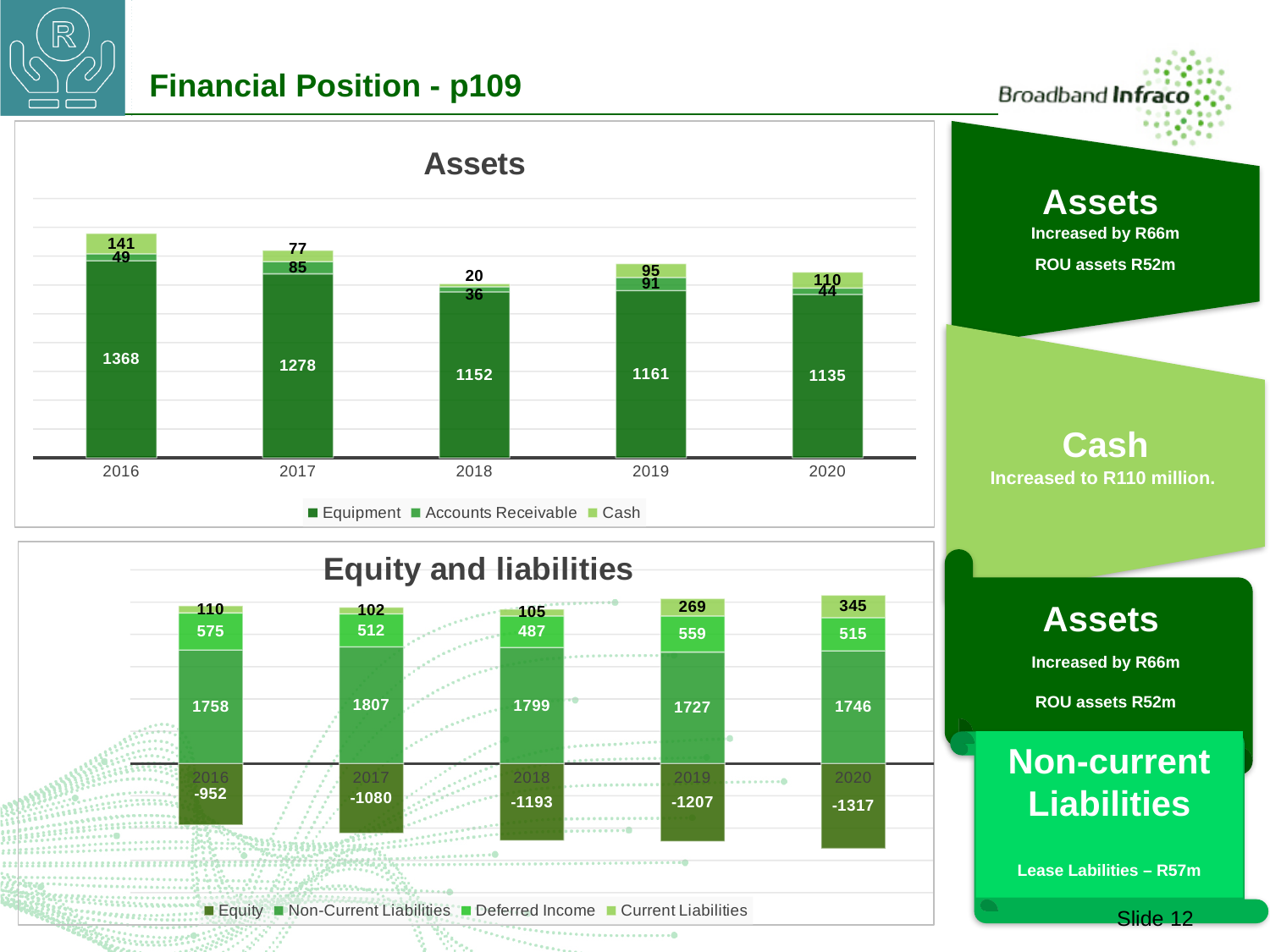
In the Assets chart, how many series does the legend list? 3 In the Equity and liabilities chart, how many categories are shown on the x axis? 5 In the Equity and liabilities chart, what is the Non-Current Liabilities value for 2017? 1807 In the Equity and liabilities chart, does the Equity value rise or fall from 2016 to 2020? Falls In the Assets chart, what is the difference between the Equipment values for 2016 and 2020? 233 In the Assets chart, what is the Equipment value for 2016? 1368 In the Assets chart, what is the Cash value for 2020? 110 In the Equity and liabilities chart, what is the Equity value for 2020? -1317 In the Assets chart, which year has the lowest Cash value? 2018 In the Assets chart, what is the total of the stacked bar for 2018? 1208 What kind of chart is the Assets chart? Stacked bar chart In the Equity and liabilities chart, which year has the highest Current Liabilities value? 2020